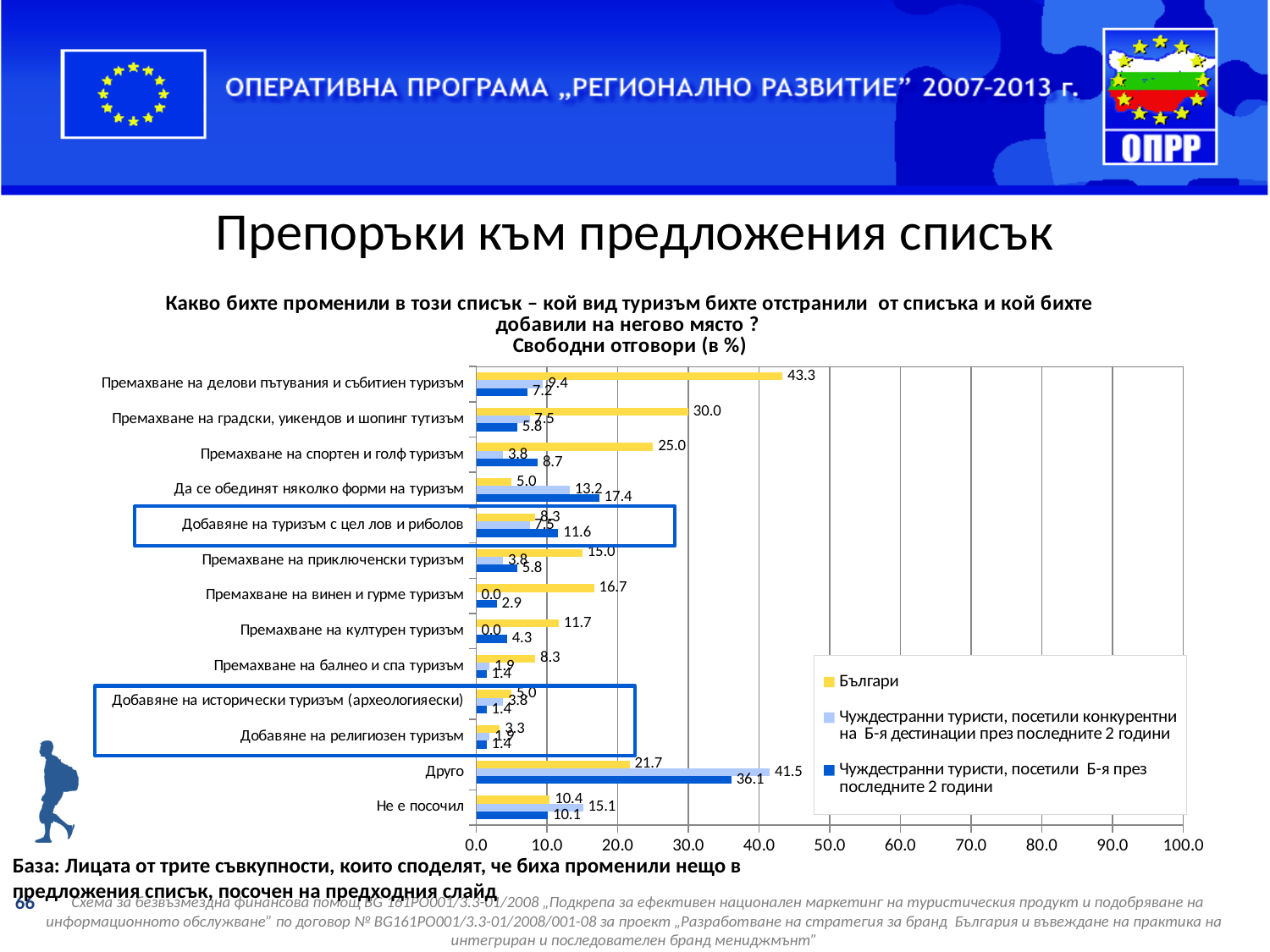
How many series does the legend list? 3 In the category "Да се обединят няколко форми на туризъм", which series has the larger value: "Чуждестранни туристи, посетили конкурентни на Б-я дестинации през последните 2 години" or "Чуждестранни туристи, посетили Б-я през последните 2 години"? Чуждестранни туристи, посетили Б-я през последните 2 години Is the value for "Българи" in the category "Премахване на спортен и голф туризъм" greater or less than 20.0? greater What is the difference between the "Българи" values for "Премахване на делови пътувания и събитиен туризъм" and "Премахване на градски, уикендов и шопинг тутизъм"? 13.3 What is the value for "Българи" in the category "Премахване на винен и гурме туризъм"? 16.7 How many categories are plotted on the chart? 13 What kind of chart is shown on the slide? Bar chart What is the value for "Чуждестранни туристи, посетили конкурентни на Б-я дестинации през последните 2 години" in the category "Друго"? 41.5 What is the value for "Българи" in the category "Премахване на делови пътувания и събитиен туризъм"? 43.3 Which category has the highest value for the "Българи" series? Премахване на делови пътувания и събитиен туризъм Which category has the highest value for the "Чуждестранни туристи, посетили Б-я през последните 2 години" series? Друго What is the value for "Чуждестранни туристи, посетили Б-я през последните 2 години" in the category "Да се обединят няколко форми на туризъм"? 17.4